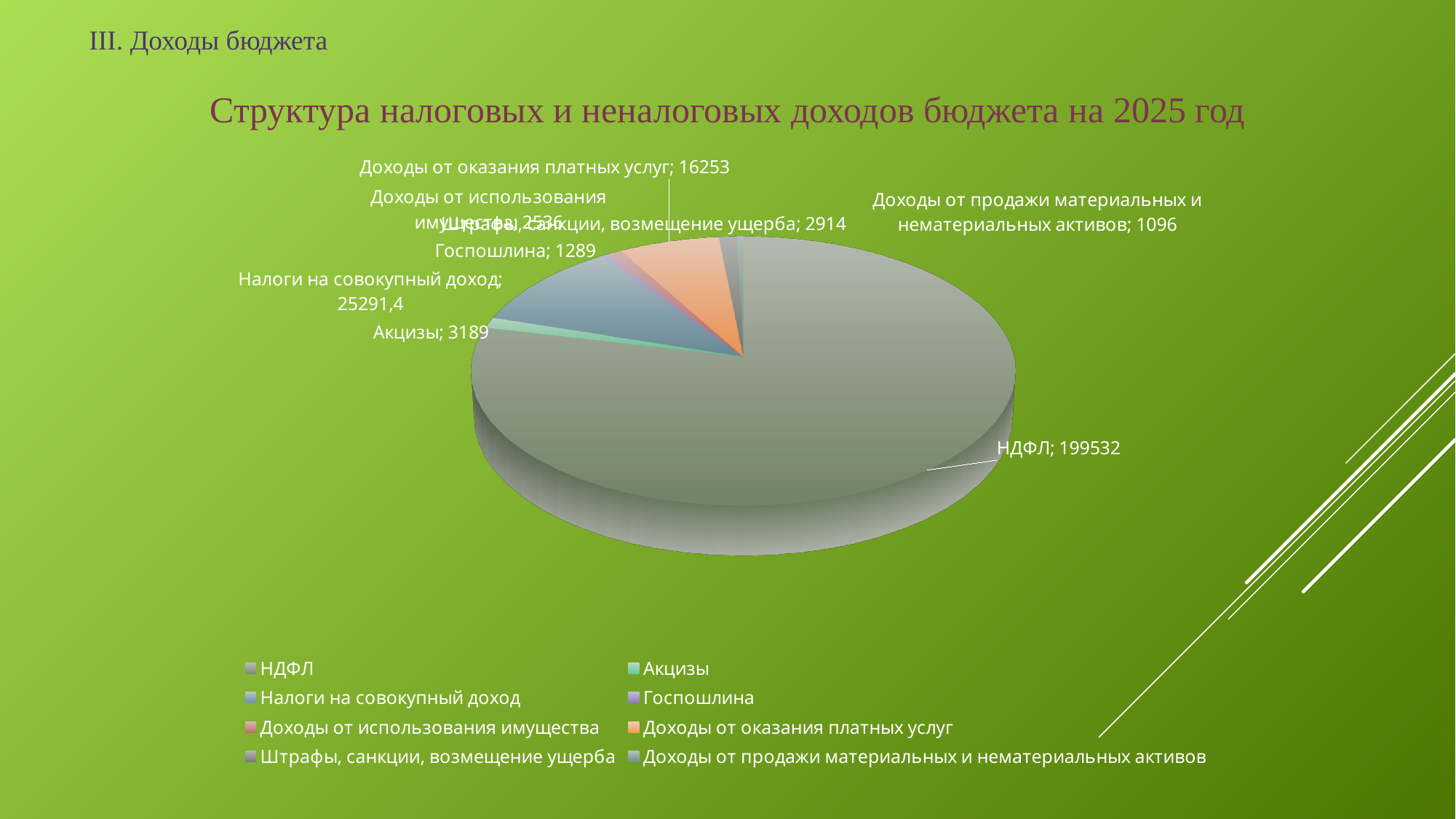
Which category has the largest value? НДФЛ What is the value for Доходы от оказания платных услуг? 16253 What is the value for Налоги на совокупный доход? 25291,4 What is the value for НДФЛ? 199532 What is the title of the chart? Структура налоговых и неналоговых доходов бюджета на 2025 год What kind of chart is shown on the slide? pie chart Which category has the smallest value? Доходы от продажи материальных и нематериальных активов What is the value for Доходы от продажи материальных и нематериальных активов? 1096 How many categories does the legend list? 8 What is the value for Акцизы? 3189 What is the difference between the values for Доходы от оказания платных услуг and Акцизы? 13064 What is the value for Госпошлина? 1289